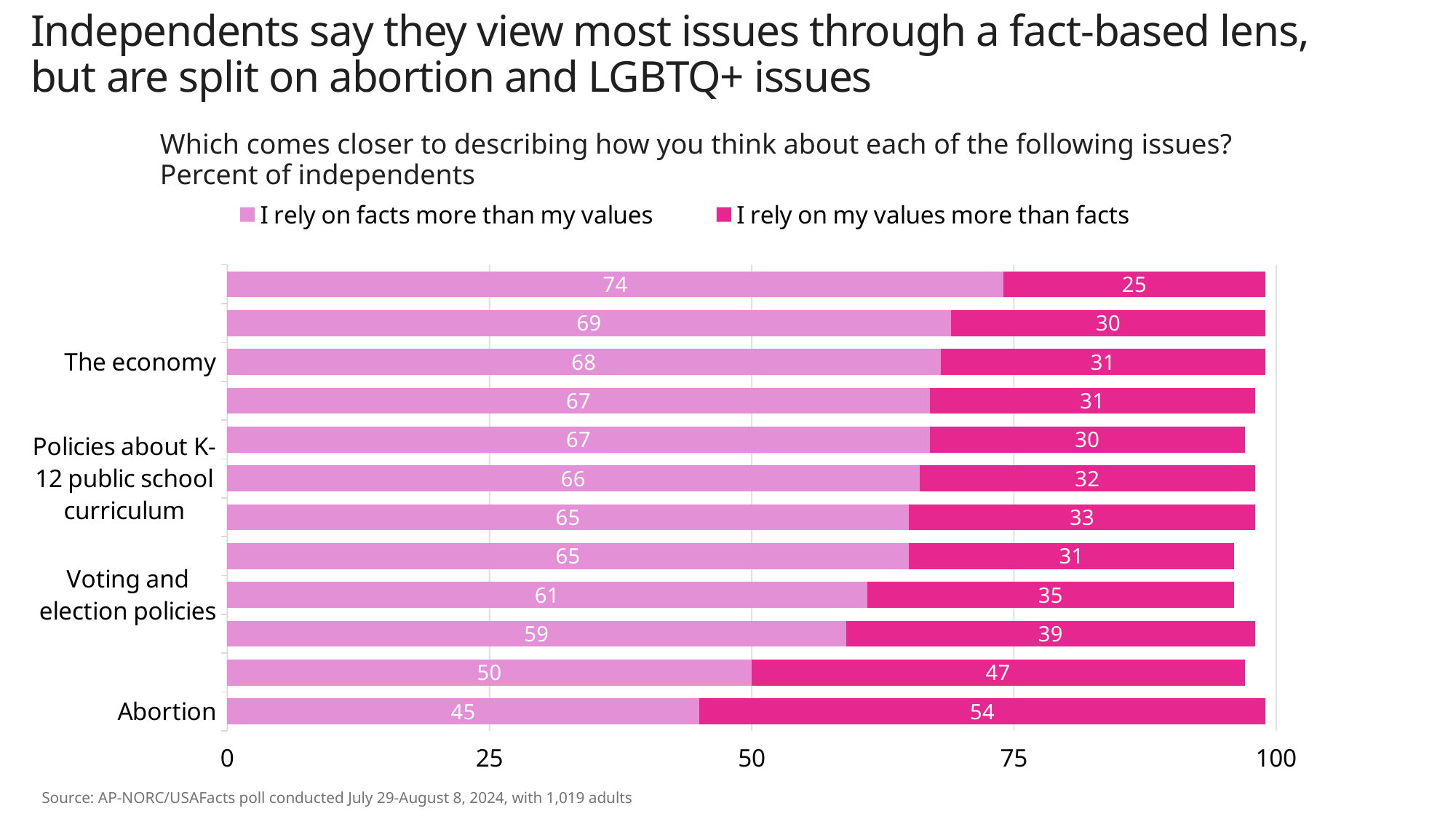
For Abortion, what is the difference between the values share and the facts share? 9 For Abortion, which is larger: 'I rely on facts more than my values' or 'I rely on my values more than facts'? I rely on my values more than facts How many series does the legend list? 2 What percent of independents say they rely on facts more than values for Abortion? 45 What percent of independents say they rely on values more than facts for Abortion? 54 How many bars (issues) are plotted in the chart? 12 What is the highest value shown for the 'I rely on facts more than my values' series? 74 Which issue has the lowest value for 'I rely on facts more than my values'? Abortion What percent of independents say they rely on values more than facts for The economy? 31 What kind of chart is shown on the slide? bar chart What percent of independents say they rely on facts more than values for The economy? 68 What is the total of the two segments in the Abortion bar? 99